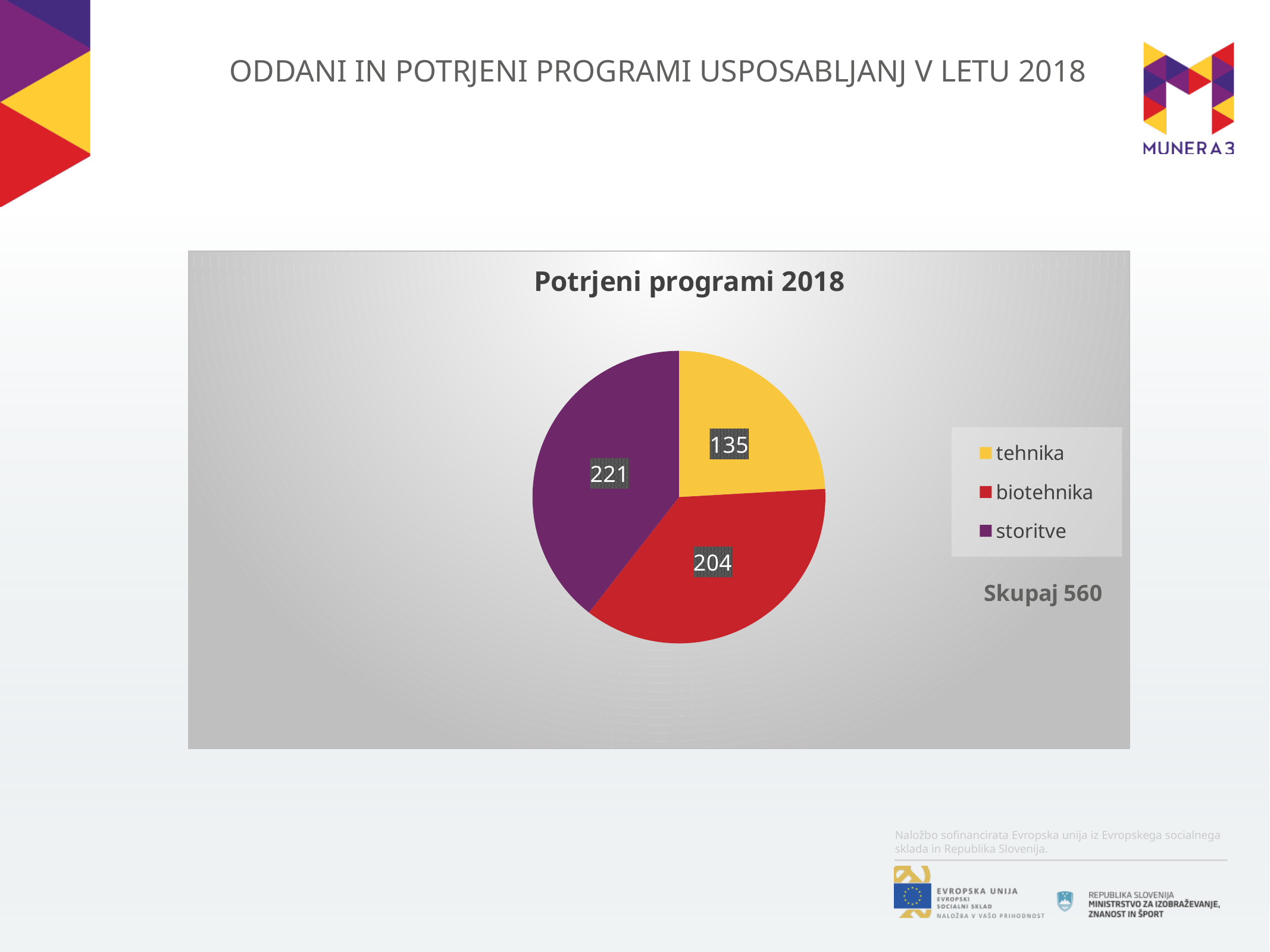
Which category has the largest slice? storitve Which is larger, the value for biotehnika or the value for tehnika? biotehnika What is the value for storitve? 221 What is the value for biotehnika? 204 What is the total of all three slices, as stated on the slide? 560 What is the difference between the values for storitve and tehnika? 86 What type of chart is shown on the slide? pie chart Which category has the smallest slice? tehnika How many entries does the legend list? 3 How many slices does the pie chart have? 3 What is the title of the chart? Potrjeni programi 2018 What is the value for tehnika? 135